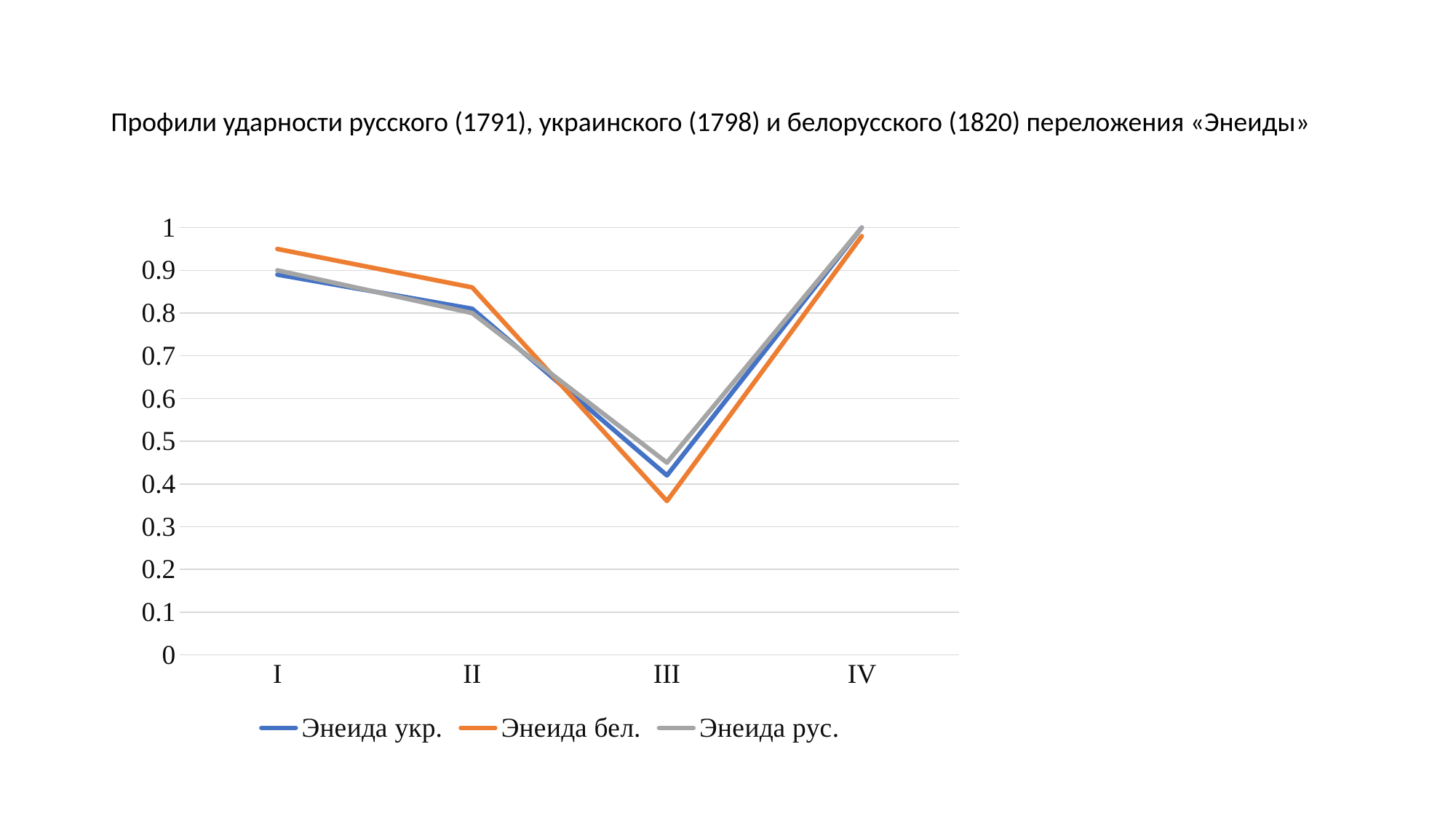
How many categories are shown on the x axis? 4 Is the value for Энеида рус. at category III greater or less than 0.5? less What kind of chart is shown on the slide? line chart Is the value for Энеида бел. at category I greater or less than 0.9? greater Which series has the lowest value at category III? Энеида бел. How many series does the legend list? 3 At which category does the Энеида бел. series reach its lowest value? III Which series has the highest value at category I? Энеида бел. Do the values of the Энеида укр. series rise or fall from category II to category III? fall What is the title of the chart? Профили ударности русского (1791), украинского (1798) и белорусского (1820) переложения «Энеиды» At which category does the Энеида укр. series reach its highest value? IV Is the value for Энеида бел. at category III greater or less than 0.4? less